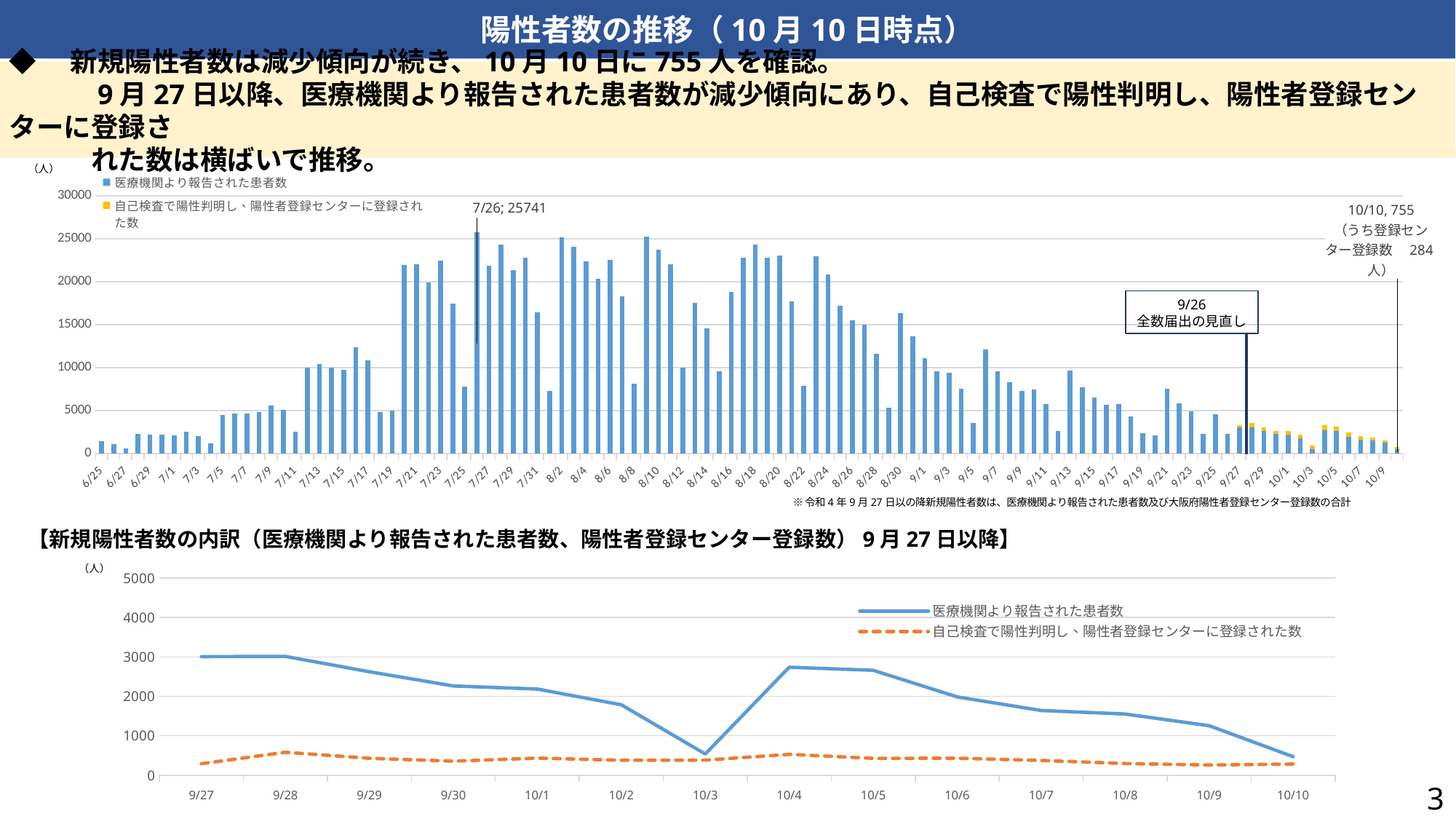
How many series does the legend of the bottom chart list? 2 In the top bar chart, which date has the highest bar? 7/26 In the bottom line chart, is the value of 医療機関より報告された患者数 on 9/27 greater or less than 2000? greater What kind of chart is the bottom chart on the slide? line chart How many series does the legend of the top chart list? 2 In the top bar chart, what total value is labeled for 10/10? 755 In the bottom line chart, which series has the larger value on 9/27: 医療機関より報告された患者数 or 自己検査で陽性判明し、陽性者登録センターに登録された数? 医療機関より報告された患者数 In the top bar chart, what value is labeled for 7/26? 25741 In the top bar chart, how many registrations at the 陽性者登録センター are noted for 10/10 in the data label? 284 What kind of chart is the top chart on the slide? bar chart How many dates are shown on the x axis of the bottom line chart? 14 In the bottom line chart, does the 医療機関より報告された患者数 line rise or fall from 10/4 to 10/10? fall